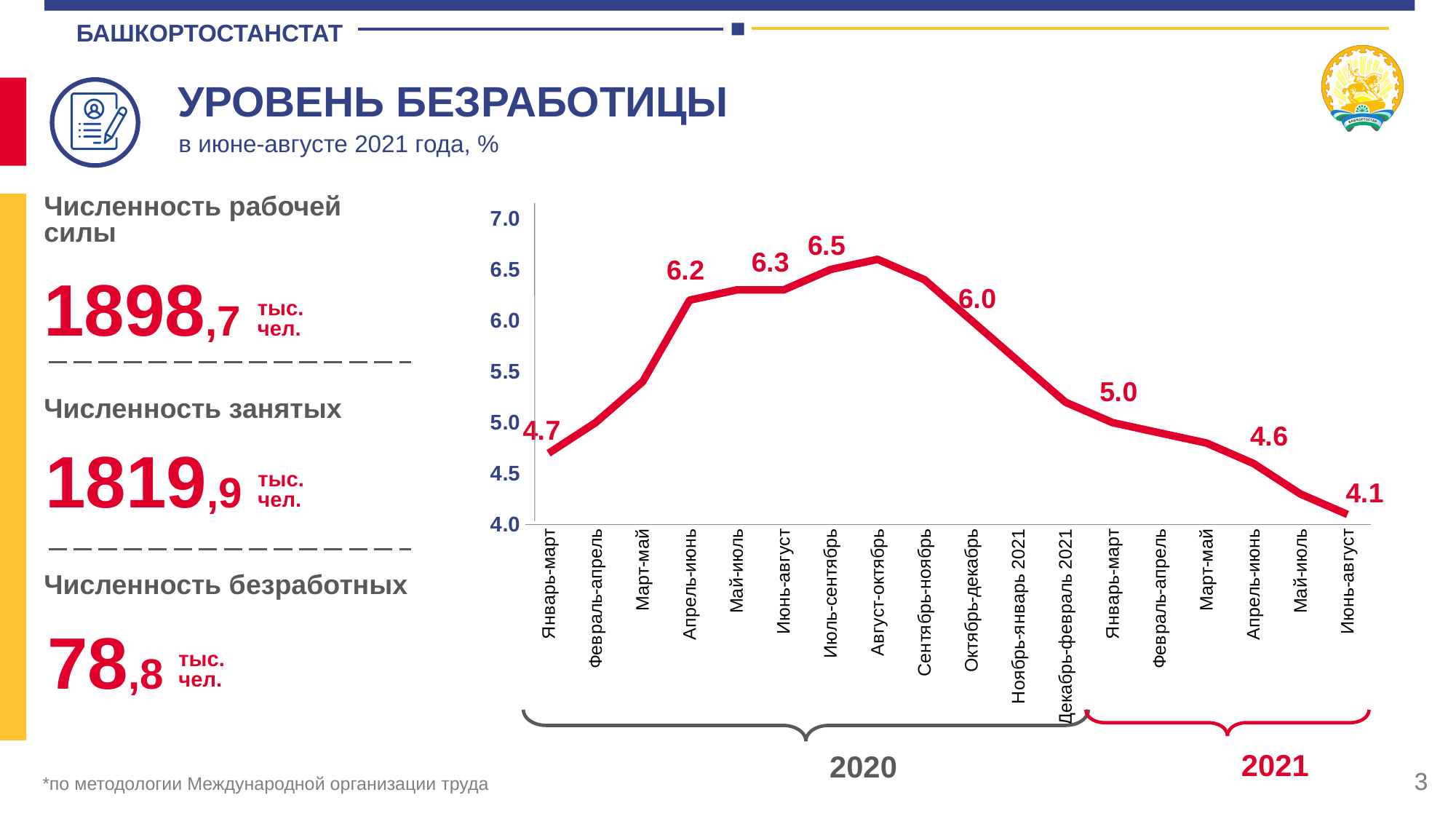
Which is larger, the unemployment rate for Апрель-июнь 2020 or Апрель-июнь 2021? Апрель-июнь 2020 What is the difference between the unemployment rate for Январь-март 2020 and Июнь-август 2021? 0.6 Which period has the lowest unemployment rate on the chart? Июнь-август 2021 What is the unemployment rate for Январь-март 2020? 4.7 What kind of chart is shown on the slide? line chart How many periods are shown on the x axis of the chart? 18 Is the value for Март-май 2020 greater or less than 5.0? greater Is the value for Сентябрь-ноябрь 2020 greater or less than 6.0? greater What is the unemployment rate for Июнь-август 2021? 4.1 What is the unemployment rate for Апрель-июнь 2020? 6.2 Does the unemployment rate rise or fall from Август-октябрь 2020 to Июнь-август 2021? fall What is the unemployment rate for Апрель-июнь 2021? 4.6